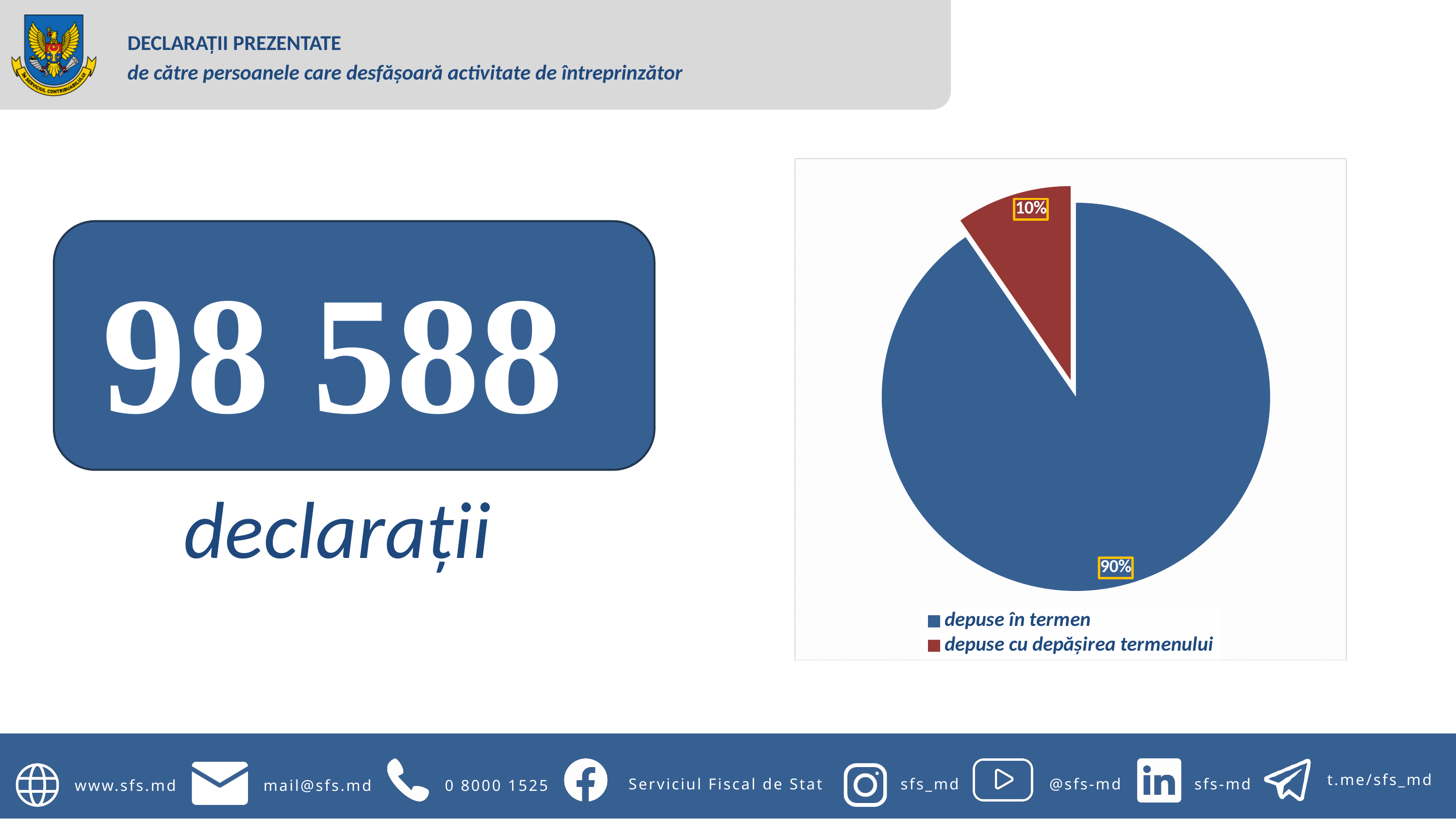
What colour is the slice for "depuse cu depășirea termenului"? red Which category has the smallest slice of the pie? depuse cu depășirea termenului What colour is the slice for "depuse în termen"? blue How many slices does the pie chart have? 2 What share of the pie is labelled "depuse în termen"? 90% What is the difference in percentage points between the "depuse în termen" slice and the "depuse cu depășirea termenului" slice? 80 percentage points Which category has the largest slice of the pie? depuse în termen Which slice is larger: "depuse în termen" or "depuse cu depășirea termenului"? depuse în termen What share of the pie is labelled "depuse cu depășirea termenului"? 10% How many entries does the legend list? 2 What kind of chart is shown on the slide? pie chart